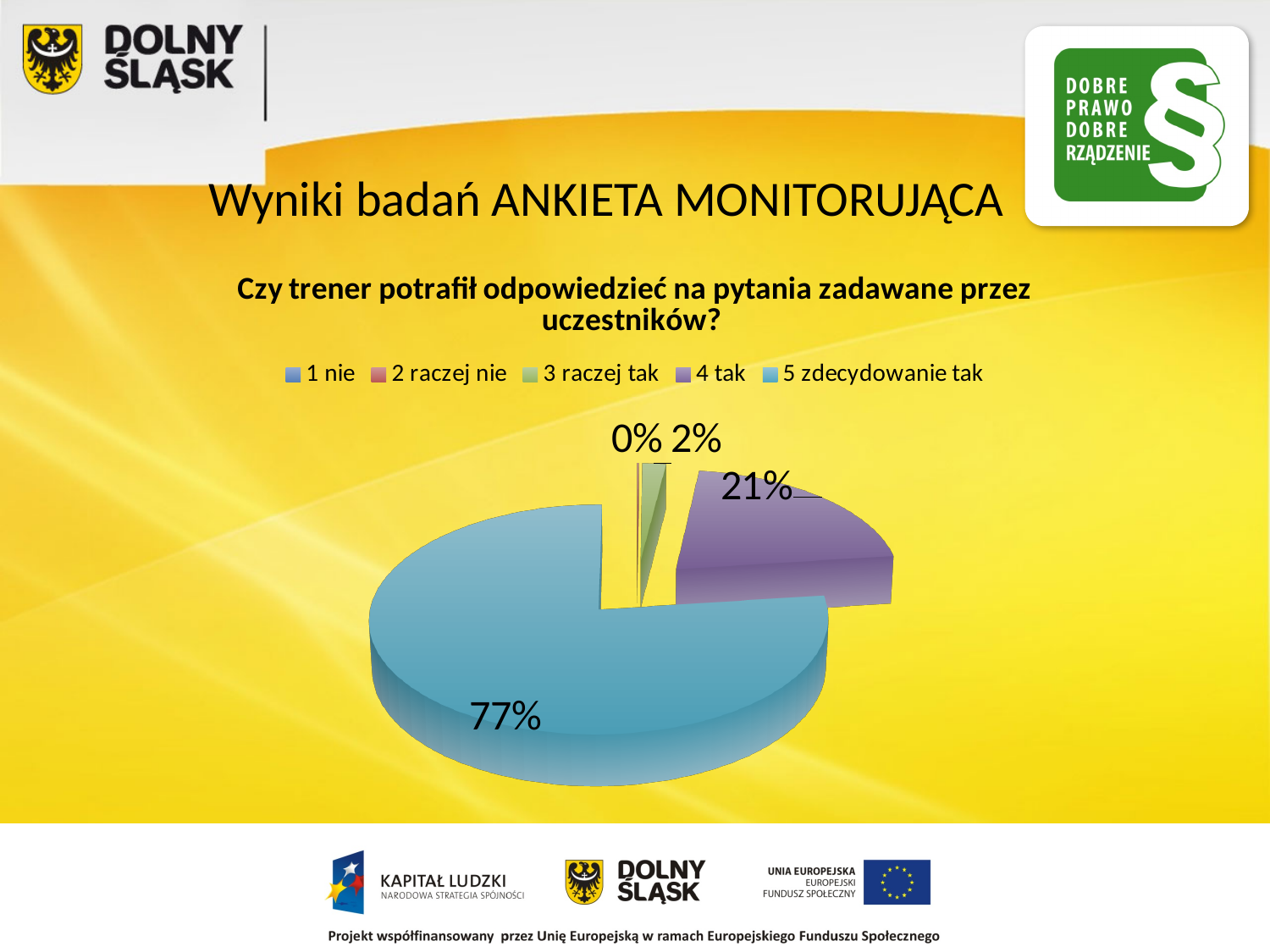
What is the difference in percentage points between the "5 zdecydowanie tak" slice and the "4 tak" slice? 56 Which is larger, the slice for "4 tak" or the slice for "3 raczej tak"? 4 tak How many entries does the chart legend list? 5 What is the combined share of the "4 tak" and "5 zdecydowanie tak" slices? 98% What kind of chart is shown on the slide? pie chart Which category has the largest slice of the pie? 5 zdecydowanie tak What is the title of the chart? Czy trener potrafił odpowiedzieć na pytania zadawane przez uczestników? What share of the pie is labelled for "3 raczej tak"? 2% Which legend entry is shown in purple? 4 tak What share of the pie is labelled for "4 tak"? 21% What share of the pie is labelled for "5 zdecydowanie tak"? 77%